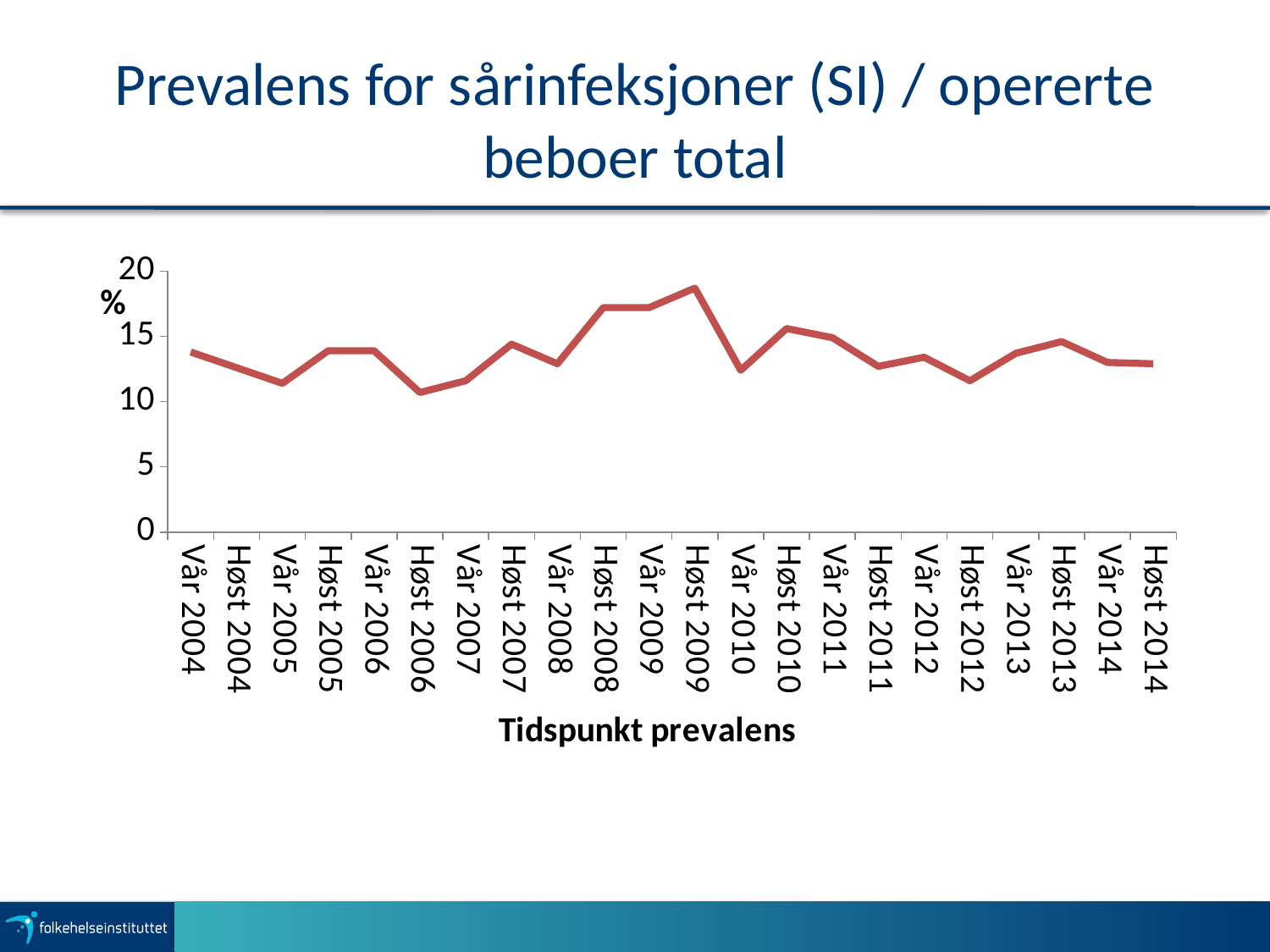
At which time point is the prevalence lowest? Høst 2006 At which time point is the prevalence highest? Høst 2009 What is the title of the x axis? Tidspunkt prevalens Is the value for Høst 2009 greater or less than 15? greater Which has the higher prevalence, Høst 2009 or Vår 2010? Høst 2009 Is the value for Vår 2010 greater or less than 15? less Is the value for Høst 2006 greater or less than 15? less What kind of chart is shown on the slide? line chart How many time points are plotted along the x axis? 22 Does the prevalence rise or fall from Høst 2009 to Vår 2010? fall